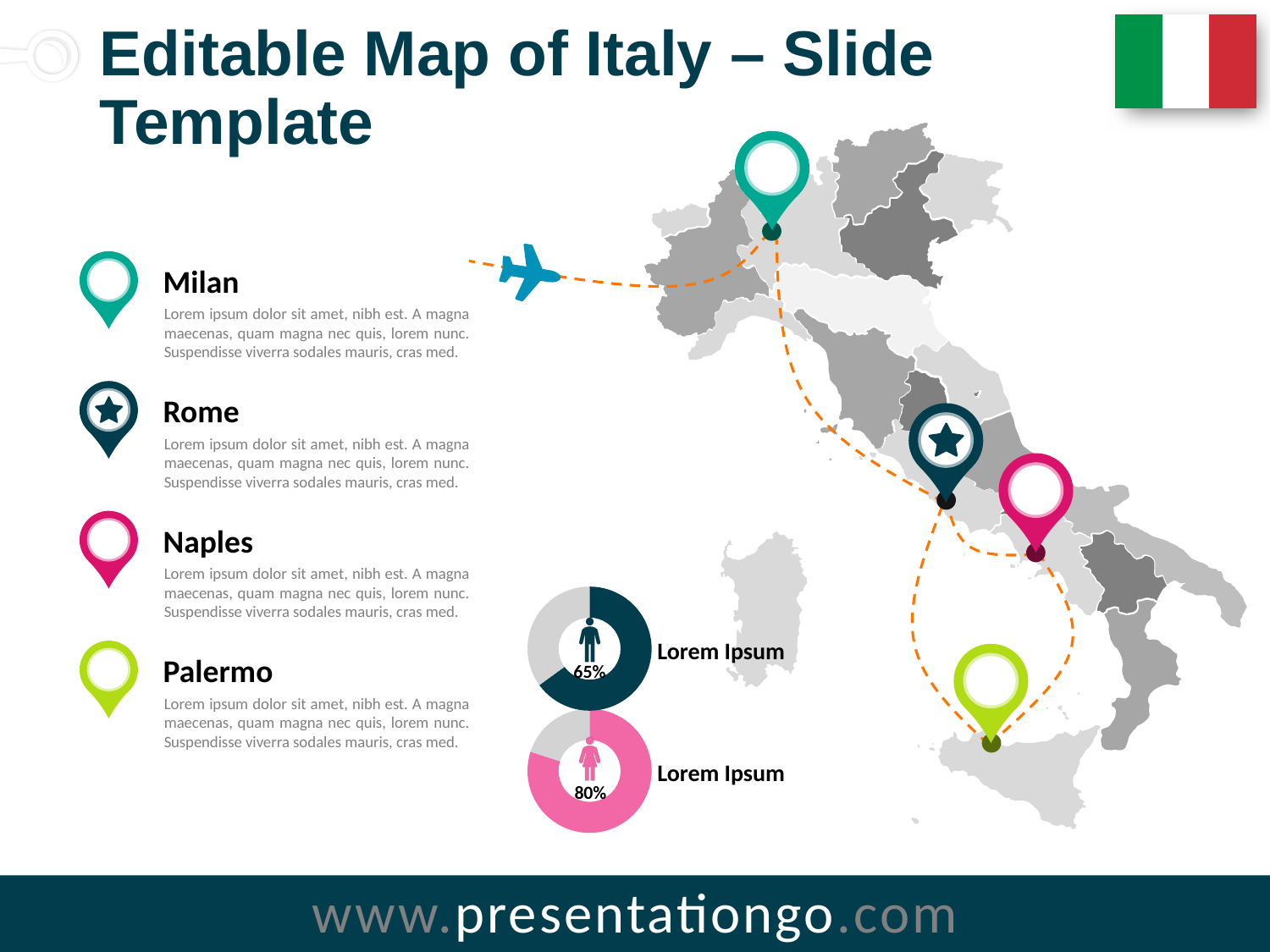
Is the value on the upper dark teal donut chart greater or less than 50%? greater What kind of chart is used to display the 65% and 80% values on the slide? donut chart Is the value on the lower pink donut chart greater or less than 75%? greater What label text appears next to each of the two donut charts? Lorem Ipsum How many donut charts are shown on the slide? 2 What colour is the filled portion of the lower donut chart showing 80%? pink What value is shown on the upper donut chart (the dark teal one with the male figure)? 65% What value is shown on the lower donut chart (the pink one with the female figure)? 80% Which of the two donut charts shows the larger percentage, the upper dark teal one or the lower pink one? the lower pink one What is the difference in percentage points between the lower pink donut chart (80%) and the upper dark teal donut chart (65%)? 15 percentage points